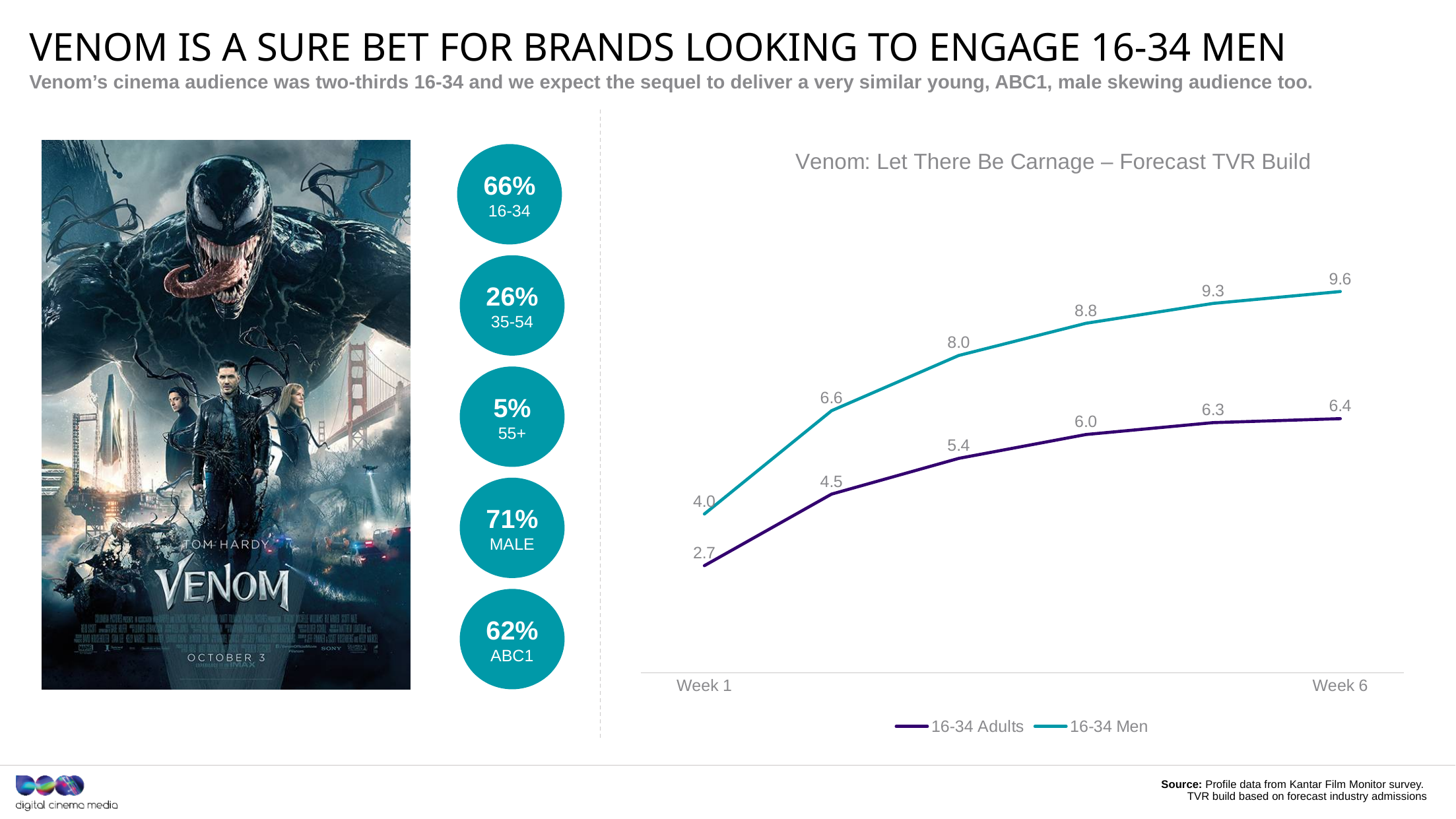
What is the forecast TVR for 16-34 Men at Week 1? 4.0 By how much does the 16-34 Men value increase from Week 1 to Week 6? 5.6 What is the forecast TVR for 16-34 Adults at Week 1? 2.7 Do the values for 16-34 Men rise or fall from Week 1 to Week 6? Rise What is the forecast TVR for 16-34 Adults at Week 6? 6.4 What is the forecast TVR for 16-34 Men at Week 6? 9.6 How many data points are plotted for each series in the chart? 6 By how much does the 16-34 Adults value increase from Week 1 to Week 6? 3.7 What kind of chart is shown on the slide? Line chart How many series does the legend of the chart list? 2 At Week 1, which series has the higher value, 16-34 Adults or 16-34 Men? 16-34 Men At Week 6, what is the difference between the 16-34 Men value and the 16-34 Adults value? 3.2